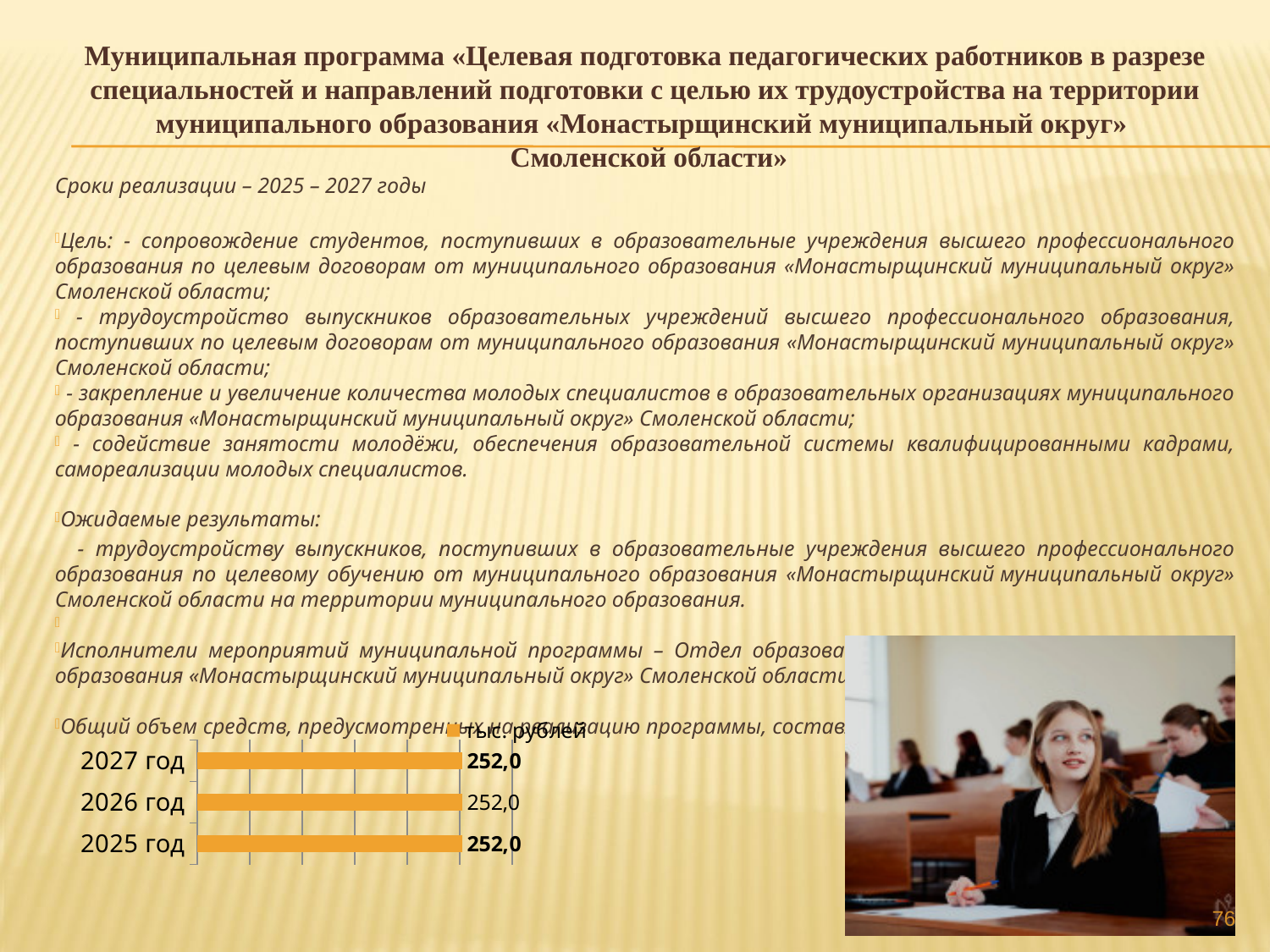
What is the difference between the values for 2027 год and 2025 год? 0,0 What is the legend entry of the chart? тыс. рублей Do the values rise, fall or stay the same from 2025 год to 2027 год? stay the same What is the value for 2027 год? 252,0 How many series does the legend list? 1 What colour are the bars in the chart? orange What is the value for 2026 год? 252,0 What is the difference between the values for 2026 год and 2025 год? 0,0 What kind of chart is shown on the slide? bar chart How many categories (years) are shown in the chart? 3 What is the value for 2025 год? 252,0